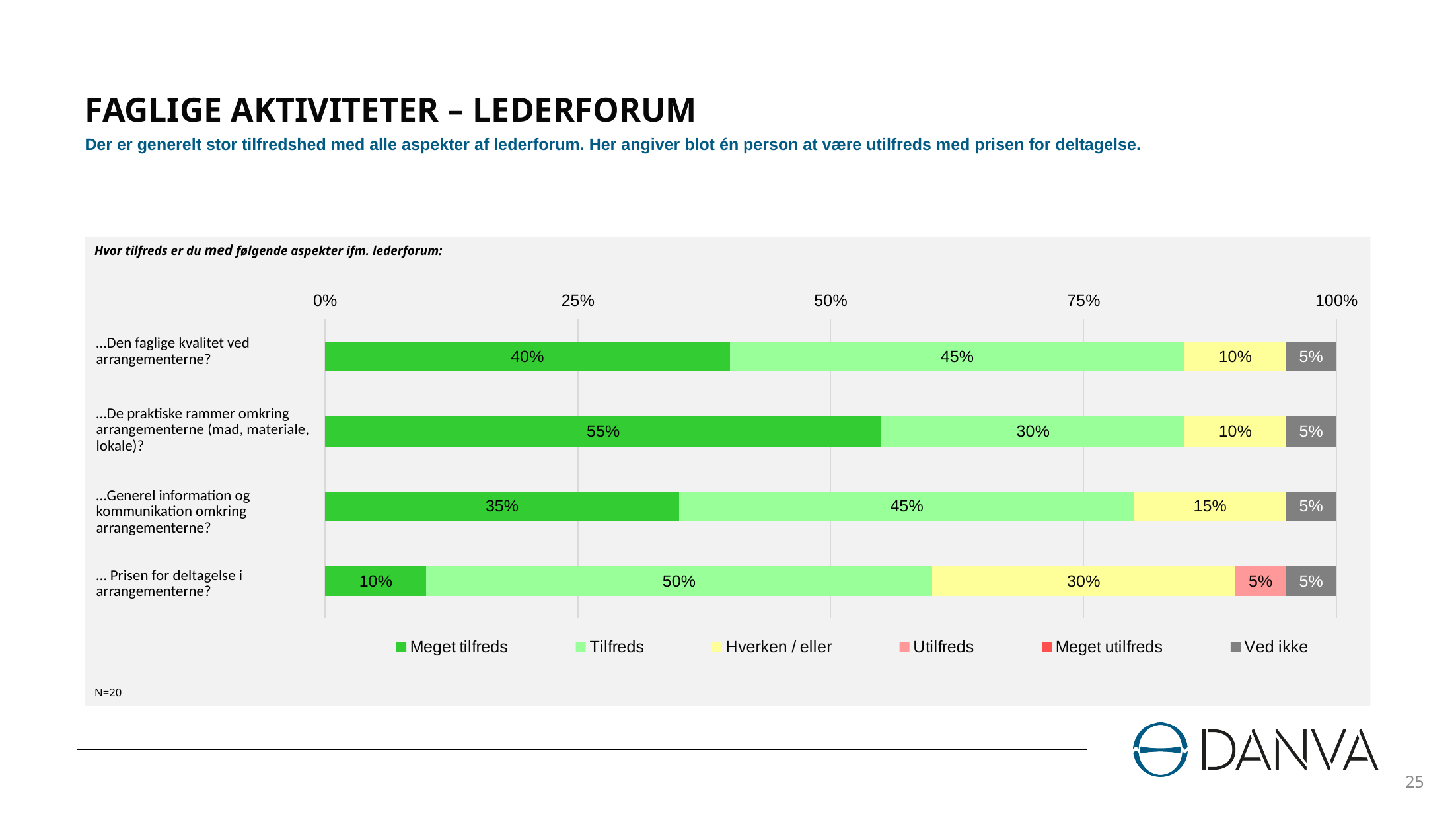
Which category is the only one with an 'Utilfreds' segment? Prisen for deltagelse i arrangementerne? What is the difference between the 'Meget tilfreds' values for 'De praktiske rammer' and 'Den faglige kvalitet'? 15% Which is larger: the 'Tilfreds' value for 'De praktiske rammer' or for 'Prisen for deltagelse'? Prisen for deltagelse What is the 'Tilfreds' value for 'Prisen for deltagelse i arrangementerne'? 50% What percentage of respondents are 'Meget tilfreds' with 'Den faglige kvalitet ved arrangementerne'? 40% How many categories (questions) are shown on the chart? 4 Which category has the lowest 'Meget tilfreds' share? Prisen for deltagelse i arrangementerne? What is the combined share of 'Meget tilfreds' and 'Tilfreds' for 'Den faglige kvalitet ved arrangementerne'? 85% Which category has the highest 'Meget tilfreds' share? De praktiske rammer omkring arrangementerne (mad, materiale, lokale)? What is the 'Hverken / eller' value for 'Generel information og kommunikation omkring arrangementerne'? 15% What kind of chart is shown on the slide? Stacked bar chart How many series does the legend list? 6